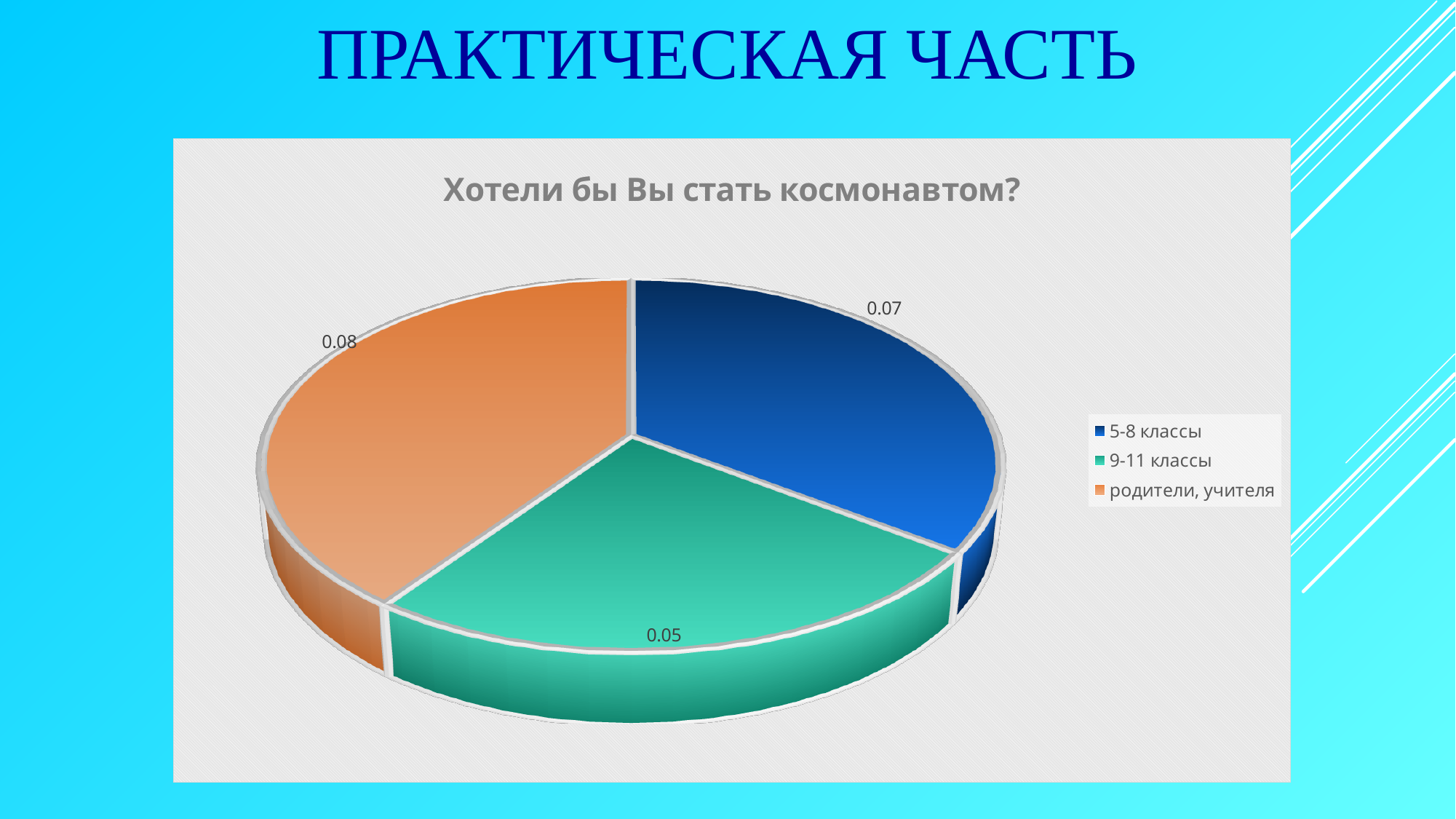
What type of chart is shown on the slide? pie chart Which is larger, the value for 5-8 классы or the value for 9-11 классы? 5-8 классы What share of the pie does the родители, учителя slice represent? 40% What is the difference between the values for родители, учителя and 9-11 классы? 0.03 What is the value for 9-11 классы? 0.05 What is the title of the chart? Хотели бы Вы стать космонавтом? How many categories does the pie chart have? 3 What is the value for родители, учителя? 0.08 Which category has the smallest slice? 9-11 классы What is the value for 5-8 классы? 0.07 Which category has the largest slice? родители, учителя Which colour represents 9-11 классы in the legend? green